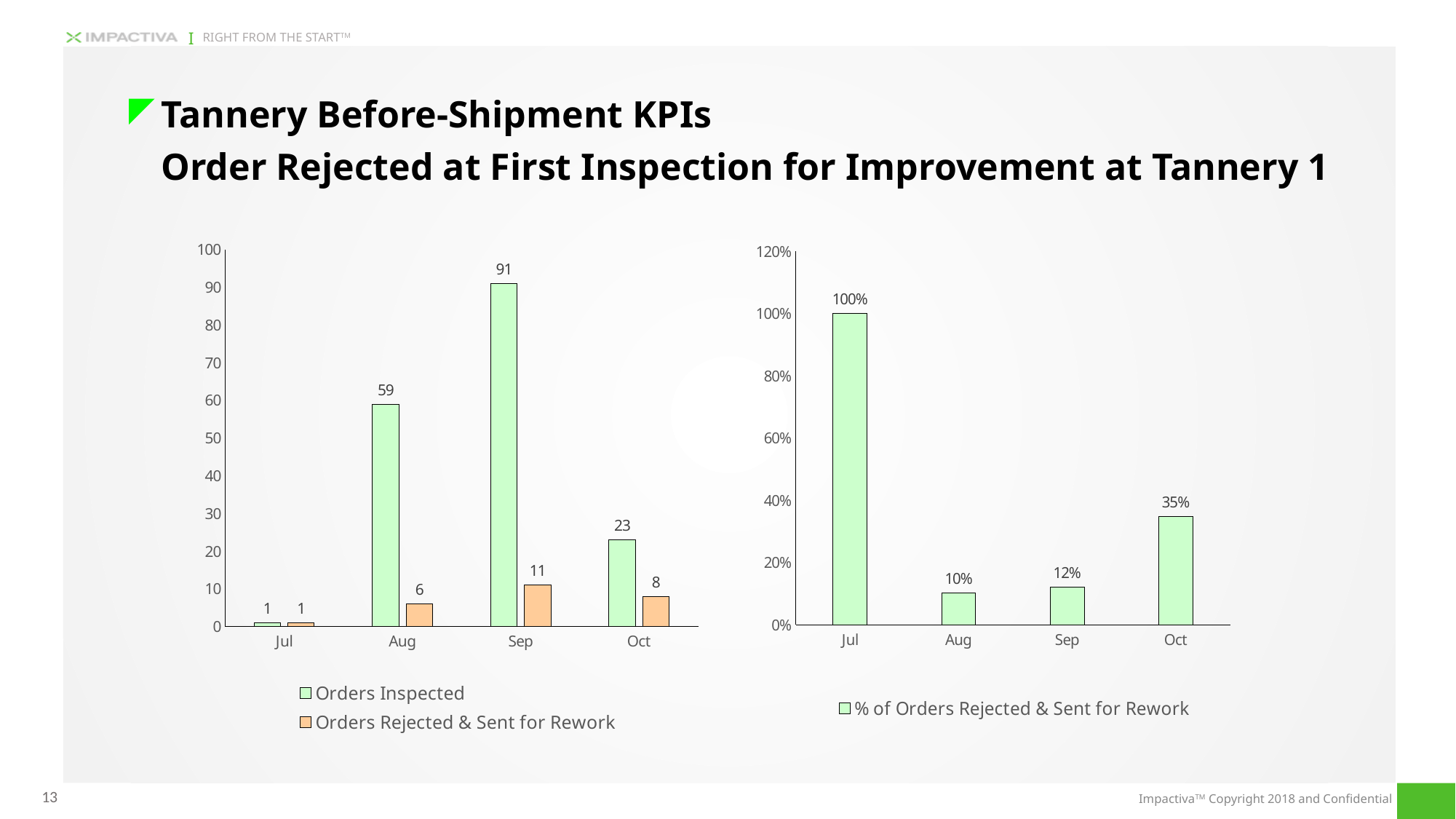
In the left chart, what is the difference between Orders Inspected and Orders Rejected & Sent for Rework in Aug? 53 In the left chart, which is larger: Orders Rejected & Sent for Rework in Sep or in Oct? Sep In the left chart, which month has the lowest number of Orders Rejected & Sent for Rework? Jul In the right chart, what is the difference between the % of Orders Rejected & Sent for Rework in Jul and in Sep? 88% What kind of chart is the right chart? Bar chart How many series does the legend of the left chart list? 2 How many months are shown on the x axis of the right chart? 4 In the left chart, which month has the highest number of Orders Inspected? Sep In the right chart, what is the % of Orders Rejected & Sent for Rework in Oct? 35% In the left chart, how many Orders Inspected were there in Sep? 91 In the right chart, which month has the lowest % of Orders Rejected & Sent for Rework? Aug In the left chart, how many Orders Rejected & Sent for Rework were there in Oct? 8